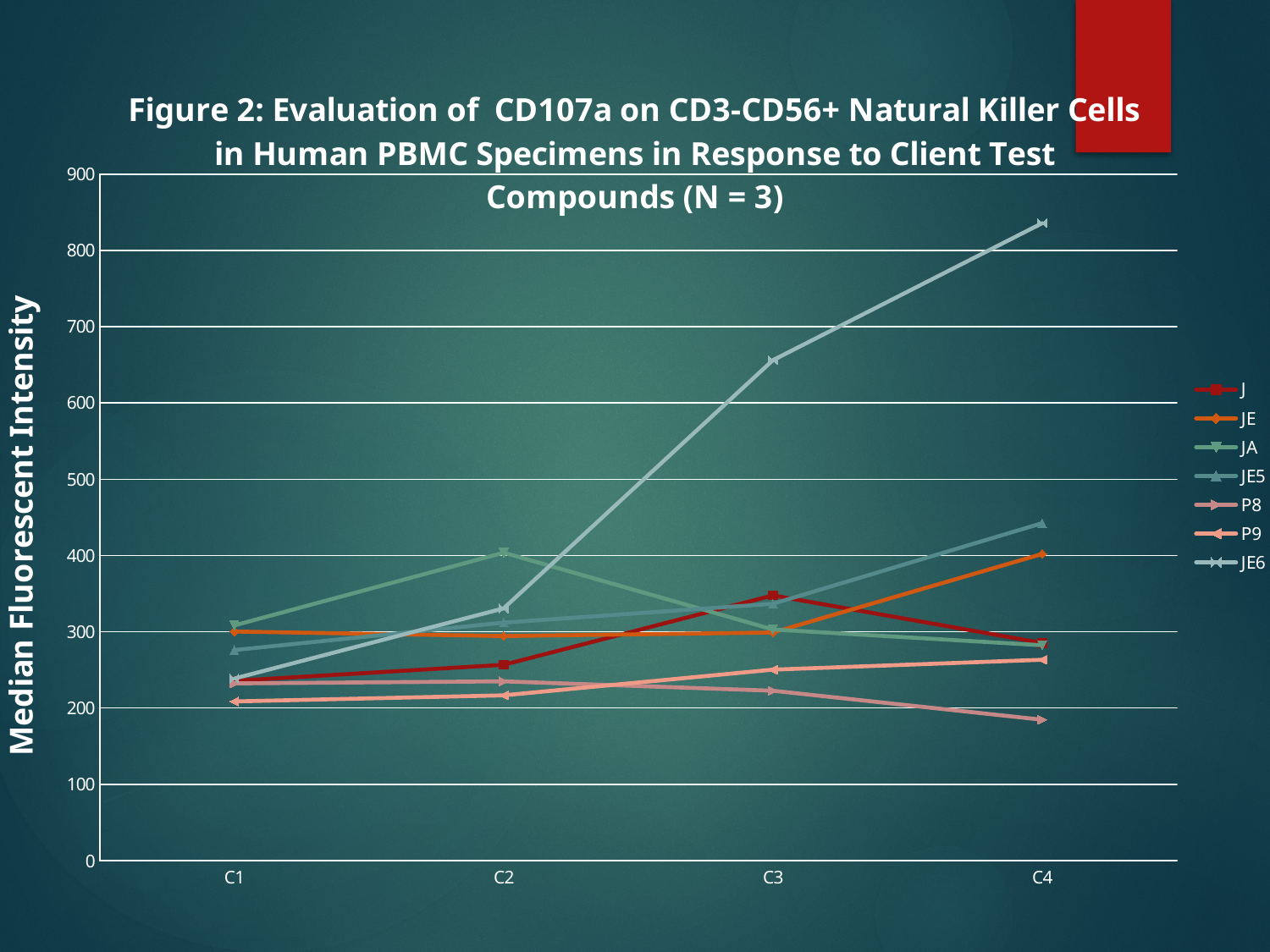
Does the JE6 series rise or fall from C1 to C4? rise Which series has the highest value at C2? JA Is the value for P8 at C4 greater or less than 200? less Is the value for JE6 at C3 greater or less than 600? greater Which series has the highest value at C4? JE6 Which series has the lowest value at C4? P8 What kind of chart is shown on the slide? line chart At C4, which is larger: JE6 or JE5? JE6 What is the title of the y axis? Median Fluorescent Intensity How many categories are shown on the x axis? 4 Is the value for JE6 at C4 greater or less than 800? greater How many series does the legend list? 7